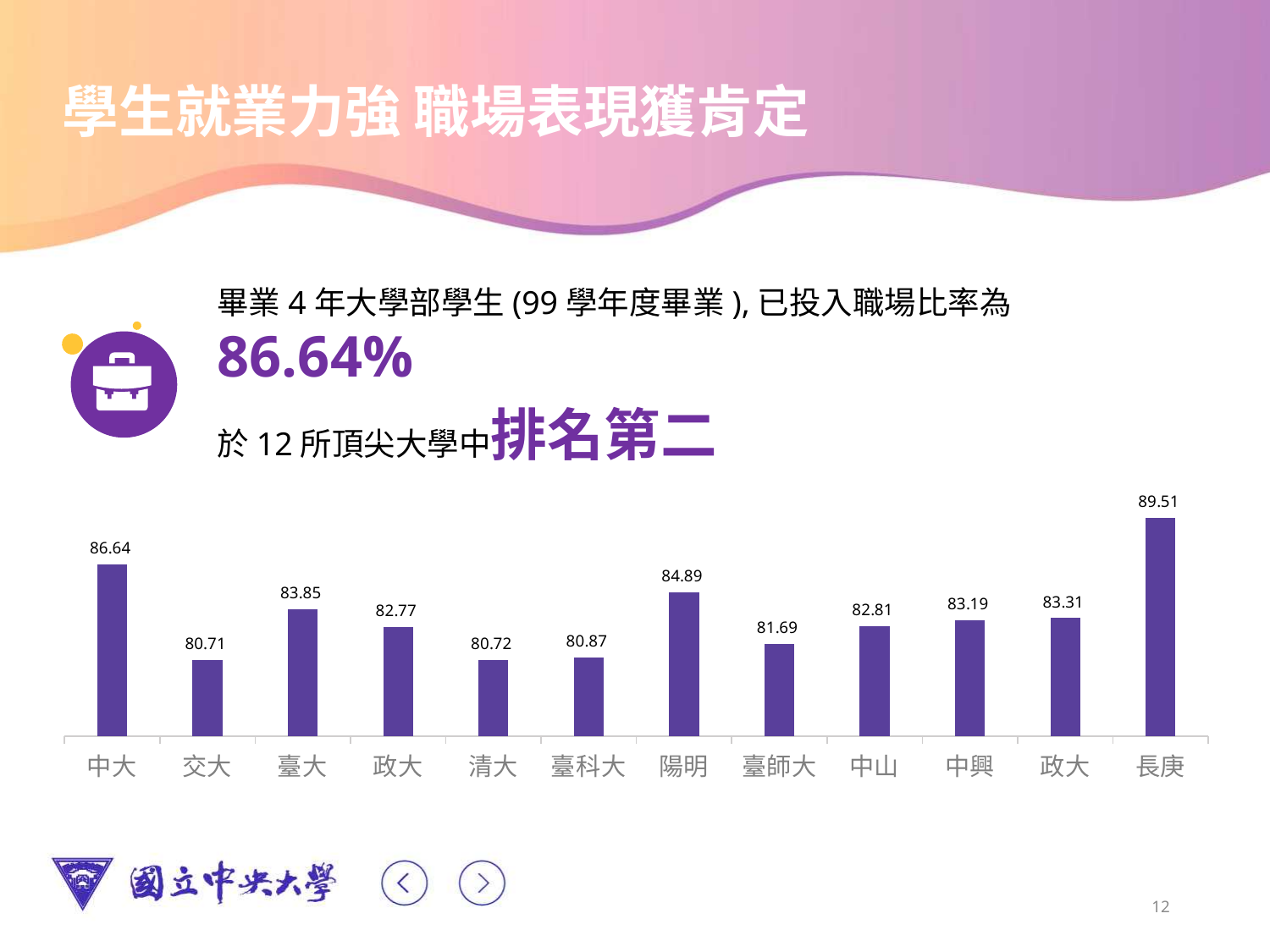
What is the value shown for 長庚 in the bar chart? 89.51 How many universities are shown in the bar chart? 12 What is the value shown for 中大 in the bar chart? 86.64 What colour are the bars in the chart? purple What is the value shown for 陽明 in the bar chart? 84.89 What is the difference between the values for 中大 and 交大? 5.93 Which has a larger value, 中興 or 中山? 中興 What is the value shown for 臺師大 in the bar chart? 81.69 What is the difference between the values for 長庚 and 中大? 2.87 What kind of chart is shown on the slide? bar chart Which university has the highest value in the bar chart? 長庚 Which has a larger value, 陽明 or 臺大? 陽明